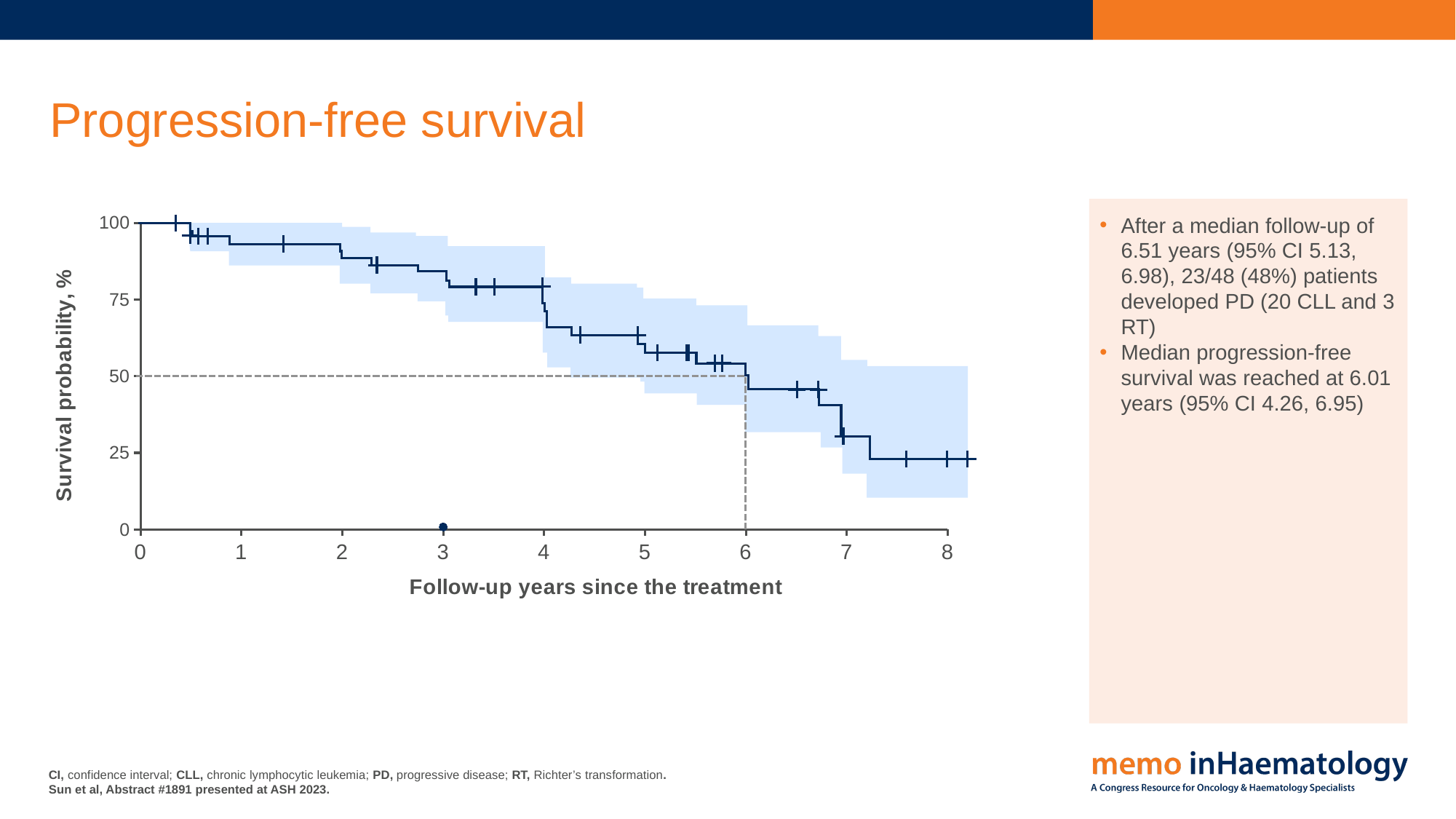
What is the highest value shown on the y axis? 100 Does the survival probability rise or fall as follow-up years increase? Fall Is the survival probability at 4.5 years greater or less than 75? less Is the survival probability at 2 years greater or less than 75? greater Is the survival probability at 1 year greater or less than 75? greater What kind of chart is shown on the slide? Line chart (Kaplan-Meier survival curve) How many tick marks are labelled on the x axis? 9 What is the title of the chart? Progression-free survival What is the label of the y axis? Survival probability, % At what survival probability value is the horizontal dashed line drawn? 50